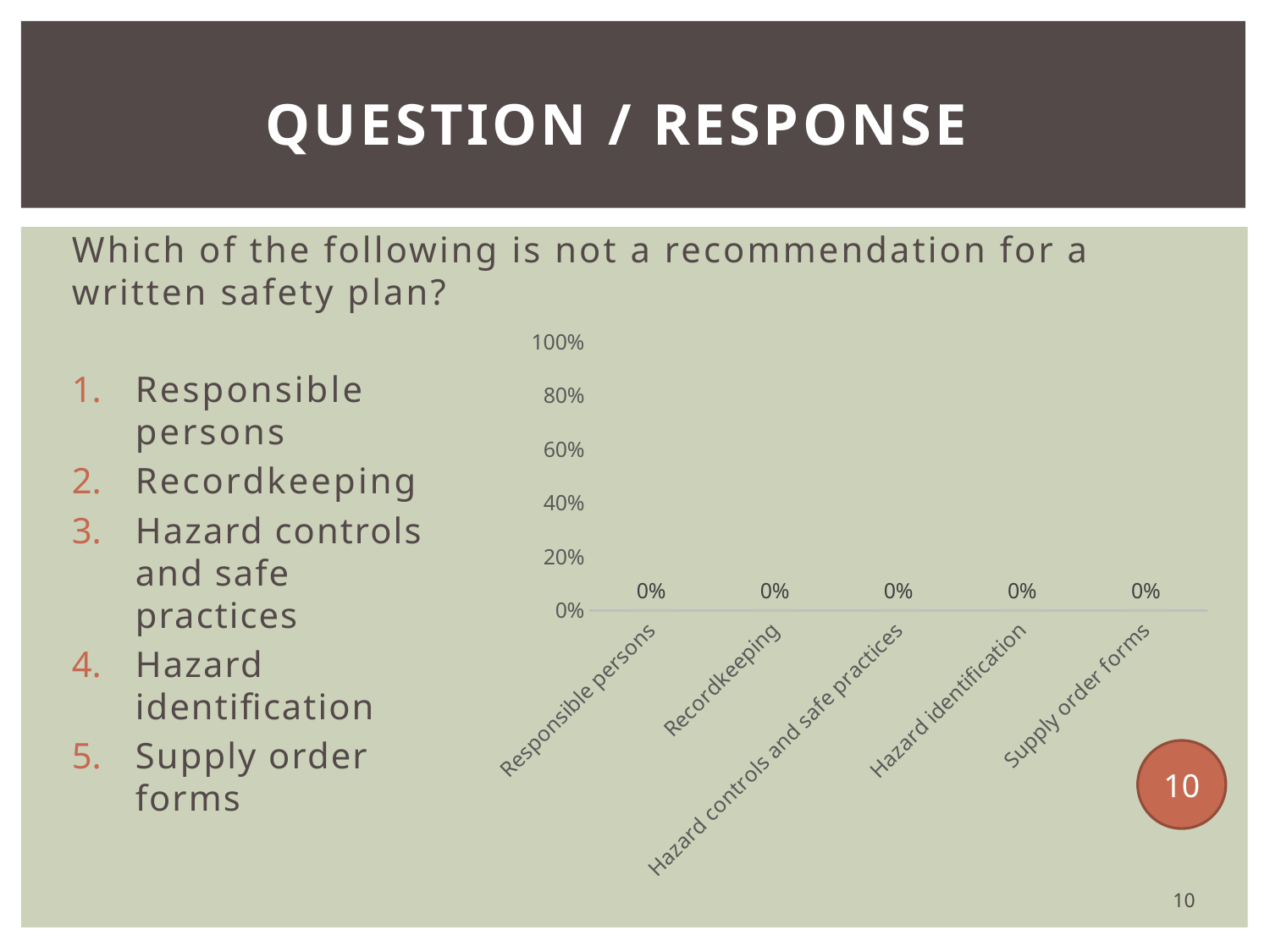
What is the value for Supply order forms? 0% What is the difference between the values for Recordkeeping and Hazard identification? 0% What is the value for Recordkeeping? 0% What is the label of the first category on the x axis? Responsible persons What is the highest value shown on the chart's vertical axis? 100% What kind of chart is shown on the slide? bar chart What is the value for Responsible persons? 0% How many categories are shown on the x axis of the chart? 5 What is the value for Hazard controls and safe practices? 0% Is the value for Supply order forms greater or less than 20%? less What is the value for Hazard identification? 0%